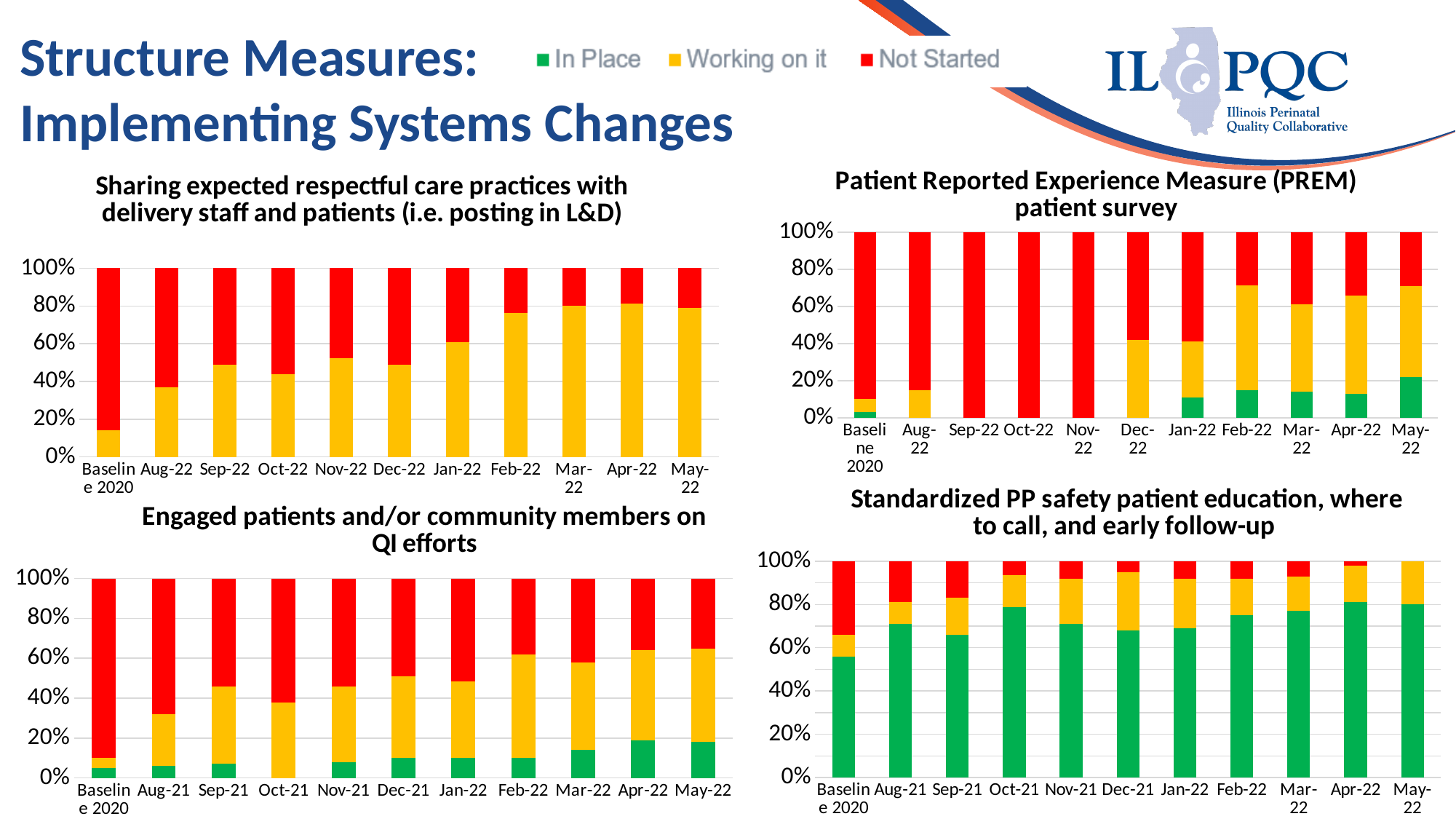
What kind of chart is the 'Engaged patients and/or community members on QI efforts' chart? stacked bar chart In the 'Patient Reported Experience Measure (PREM) patient survey' chart, what is the 'Not Started' value for Oct-22? 100% In the 'Sharing expected respectful care practices with delivery staff and patients' chart, is the 'Working on it' value for Feb-22 greater or less than 60%? greater In the 'Standardized PP safety patient education, where to call, and early follow-up' chart, is the 'In Place' value for Baseline 2020 greater or less than 40%? greater In the 'Engaged patients and/or community members on QI efforts' chart, is the 'Not Started' value for Baseline 2020 greater or less than 80%? greater Which colour represents 'Not Started' in the legend? red How many series does the legend at the top of the slide list? 3 In the 'Engaged patients and/or community members on QI efforts' chart, does the 'In Place' share generally rise or fall from Baseline 2020 to May-22? rise How many time-period categories are shown on the x axis of the 'Patient Reported Experience Measure (PREM) patient survey' chart? 11 In the 'Standardized PP safety patient education, where to call, and early follow-up' chart, which has the larger 'In Place' value, Baseline 2020 or Aug-21? Aug-21